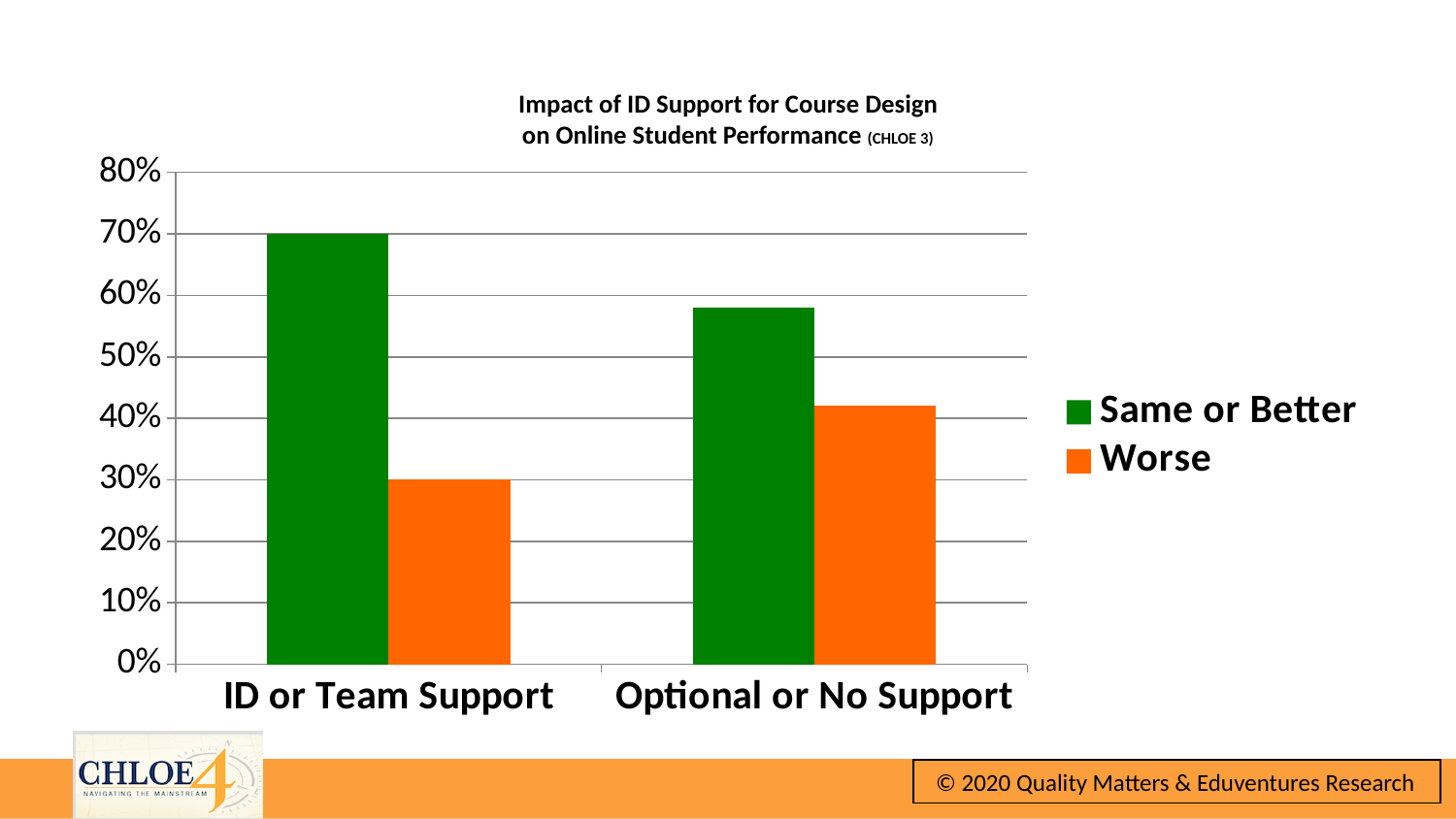
What is the difference between Same or Better and Worse for ID or Team Support? 40% Which category has the highest Same or Better value? ID or Team Support Which category has the lowest Worse value? ID or Team Support What is the title of the chart? Impact of ID Support for Course Design on Online Student Performance (CHLOE 3) Is the value for Worse under Optional or No Support greater or less than 50%? less What is the value for Same or Better under ID or Team Support? 70% What kind of chart is shown on the slide? Bar chart Is the value for Same or Better under Optional or No Support greater or less than 50%? greater Which is larger: the Worse value for ID or Team Support or the Worse value for Optional or No Support? Optional or No Support What is the value for Worse under ID or Team Support? 30% How many series does the legend list? 2 How many categories are shown on the x axis? 2